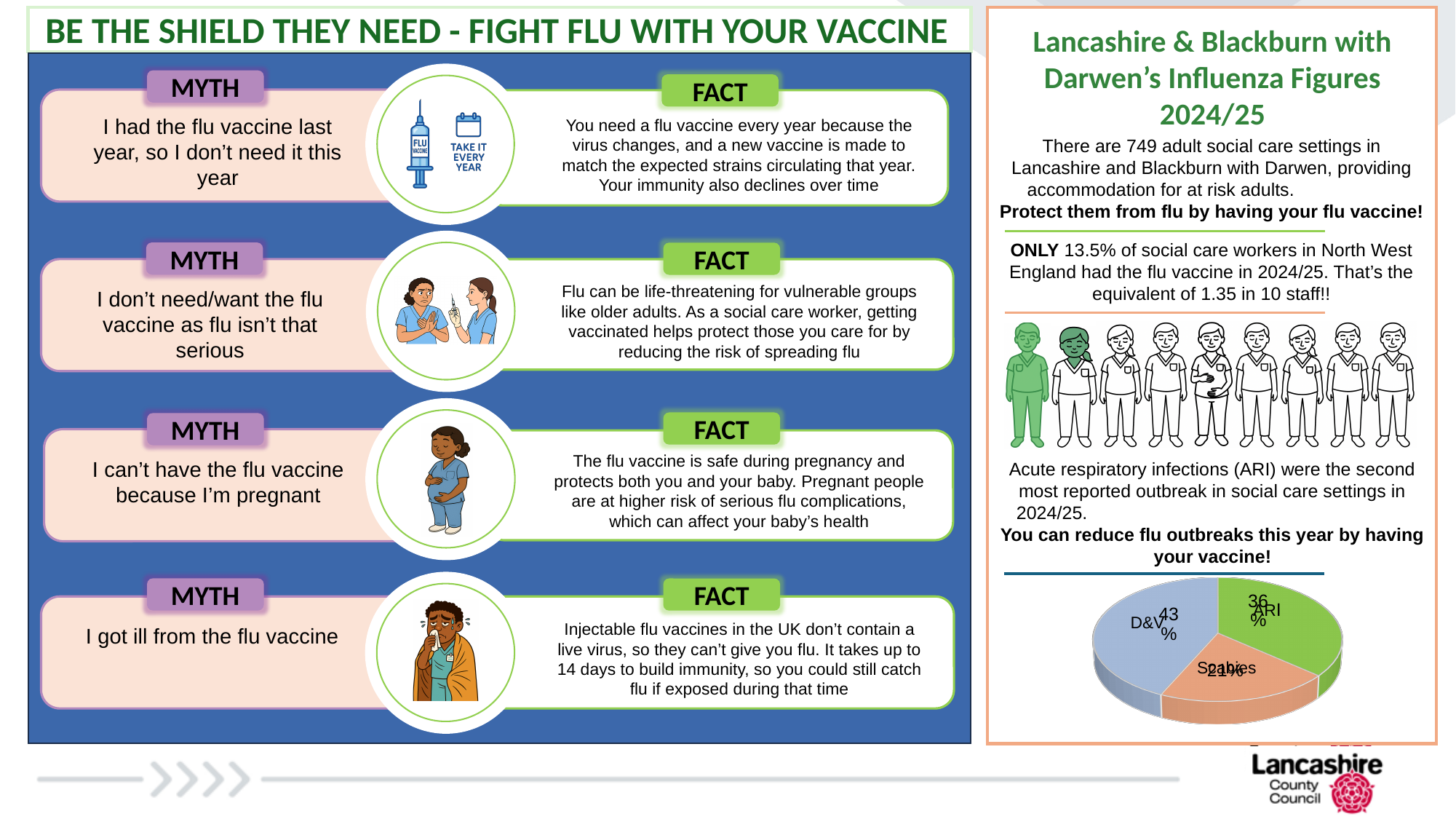
What share of the pie chart does the Scabies slice represent? 21% Which category has the smallest slice in the pie chart? Scabies How many slices does the pie chart have? 3 Which category has the largest slice in the pie chart? D&V What colour is the ARI slice in the pie chart? green In the pie chart, which is larger, the ARI slice or the Scabies slice? ARI In the pie chart, what percentage is shown for Scabies? 21% In the pie chart, what is the difference in percentage points between ARI and Scabies? 15 In the pie chart, what is the difference in percentage points between D&V and ARI? 7 In the pie chart, what percentage is shown for ARI? 36% What kind of chart is shown at the bottom right of the slide? pie chart In the pie chart, what percentage is shown for D&V? 43%